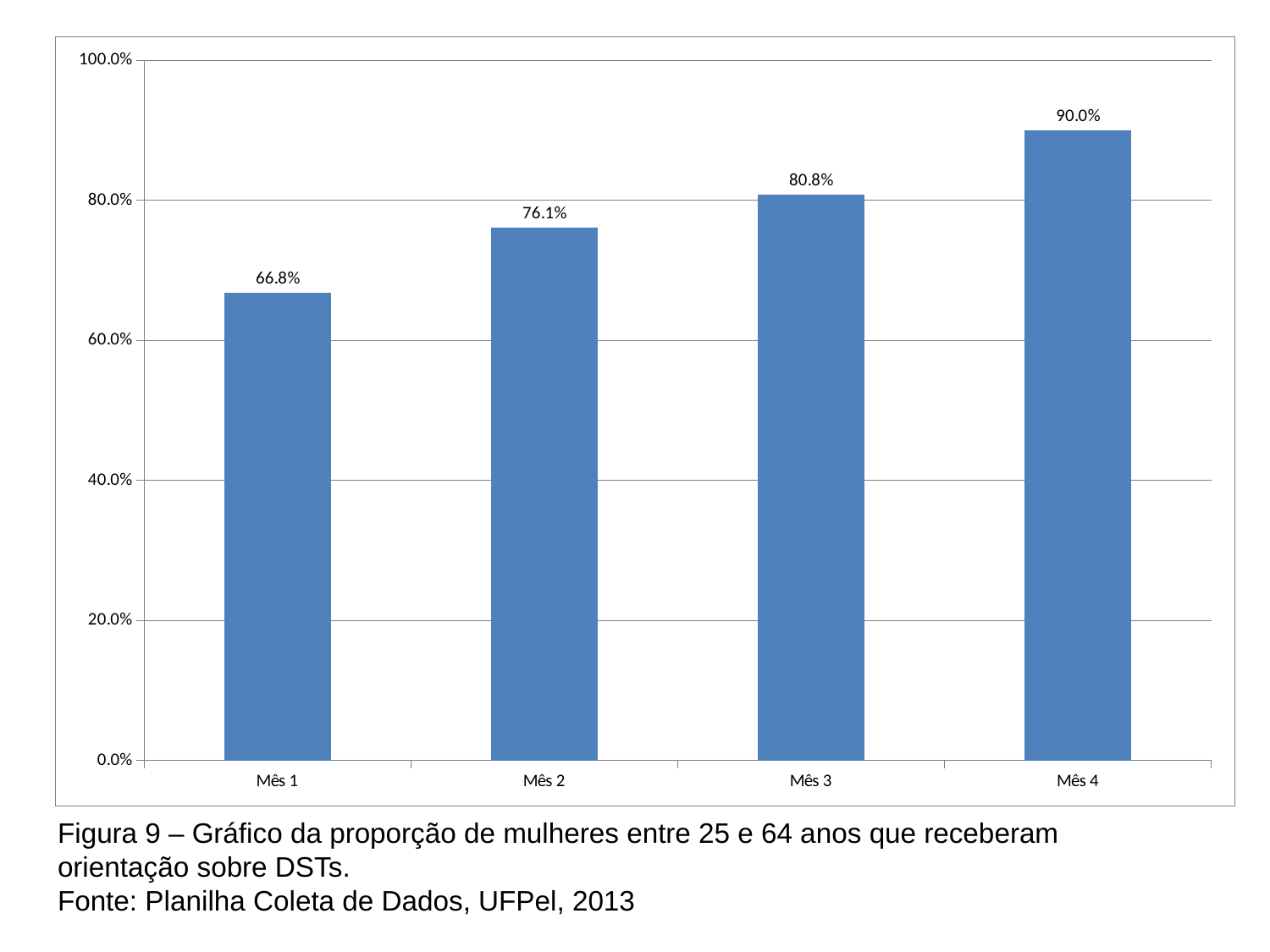
Which month has the lowest value? Mês 1 What is the difference between the values for Mês 3 and Mês 2? 4.7% What is the difference between the values for Mês 4 and Mês 1? 23.2% Which is larger, the value for Mês 2 or the value for Mês 3? Mês 3 Is the value for Mês 1 greater or less than 60.0%? greater How many months are shown on the x axis? 4 What is the value for Mês 4? 90.0% What kind of chart is shown on the slide? Bar chart What is the value for Mês 1? 66.8% What is the value for Mês 2? 76.1% What is the value for Mês 3? 80.8% Which month has the highest value? Mês 4